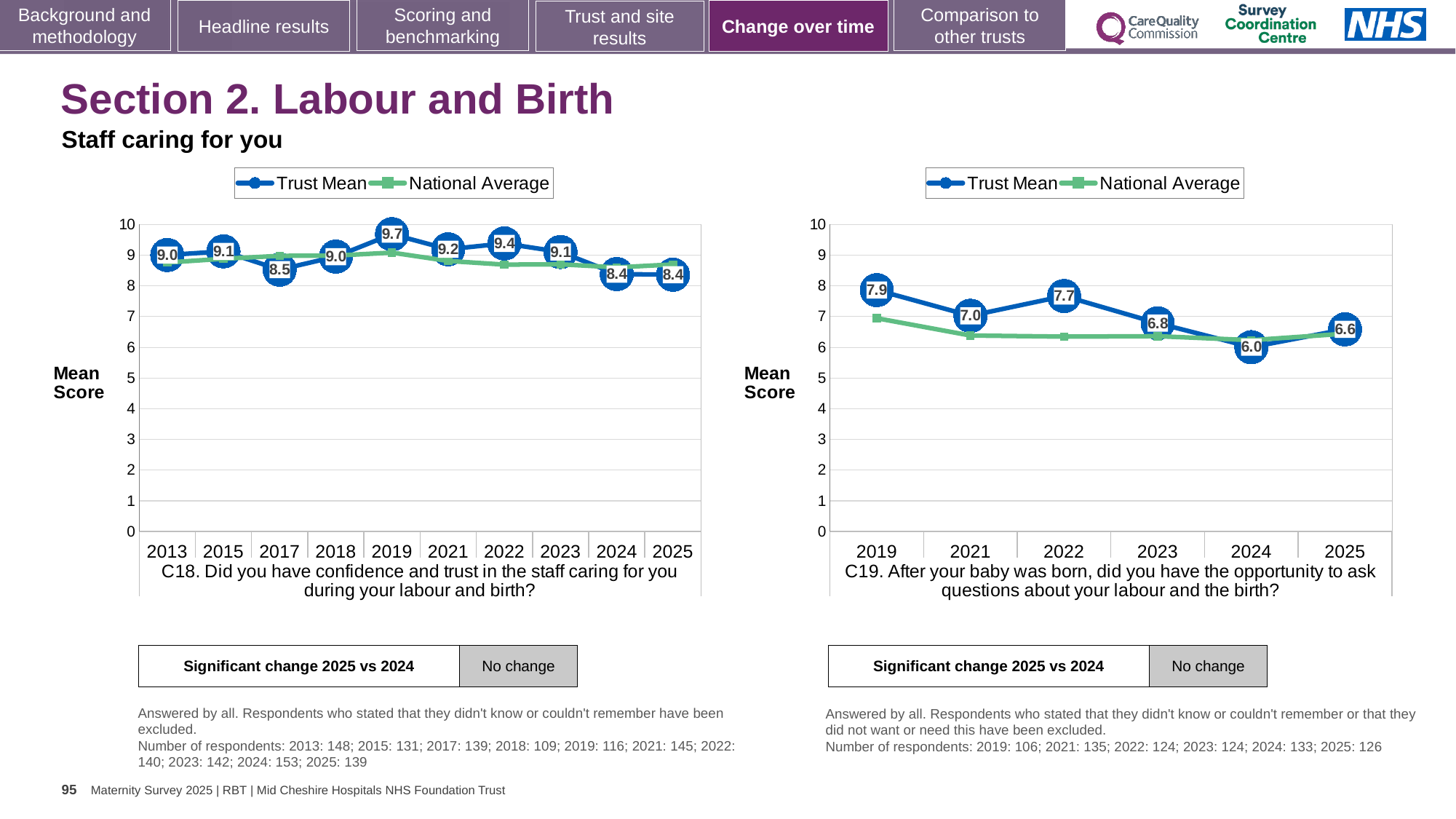
In the C18 chart (left), which year has the highest Trust Mean score? 2019 In the C19 chart (right), is the Trust Mean score for 2021 or 2022 larger? 2022 How many series does the legend of the C19 chart (right) list? 2 In the C18 chart (left), what is the difference between the Trust Mean scores for 2019 and 2017? 1.2 In the C18 chart (left), how many years are shown on the x axis? 10 In the C19 chart (right), which year has the lowest Trust Mean score? 2024 In the C18 chart (left), what is the Trust Mean score for 2025? 8.4 In the C19 chart (right), is the National Average value for 2019 greater or less than 6? greater What type of chart is the C18 chart (left)? Line chart In the C18 chart (left), what is the Trust Mean score for 2019? 9.7 In the C19 chart (right), what is the Trust Mean score for 2022? 7.7 In the C19 chart (right), which year has the highest Trust Mean score? 2019